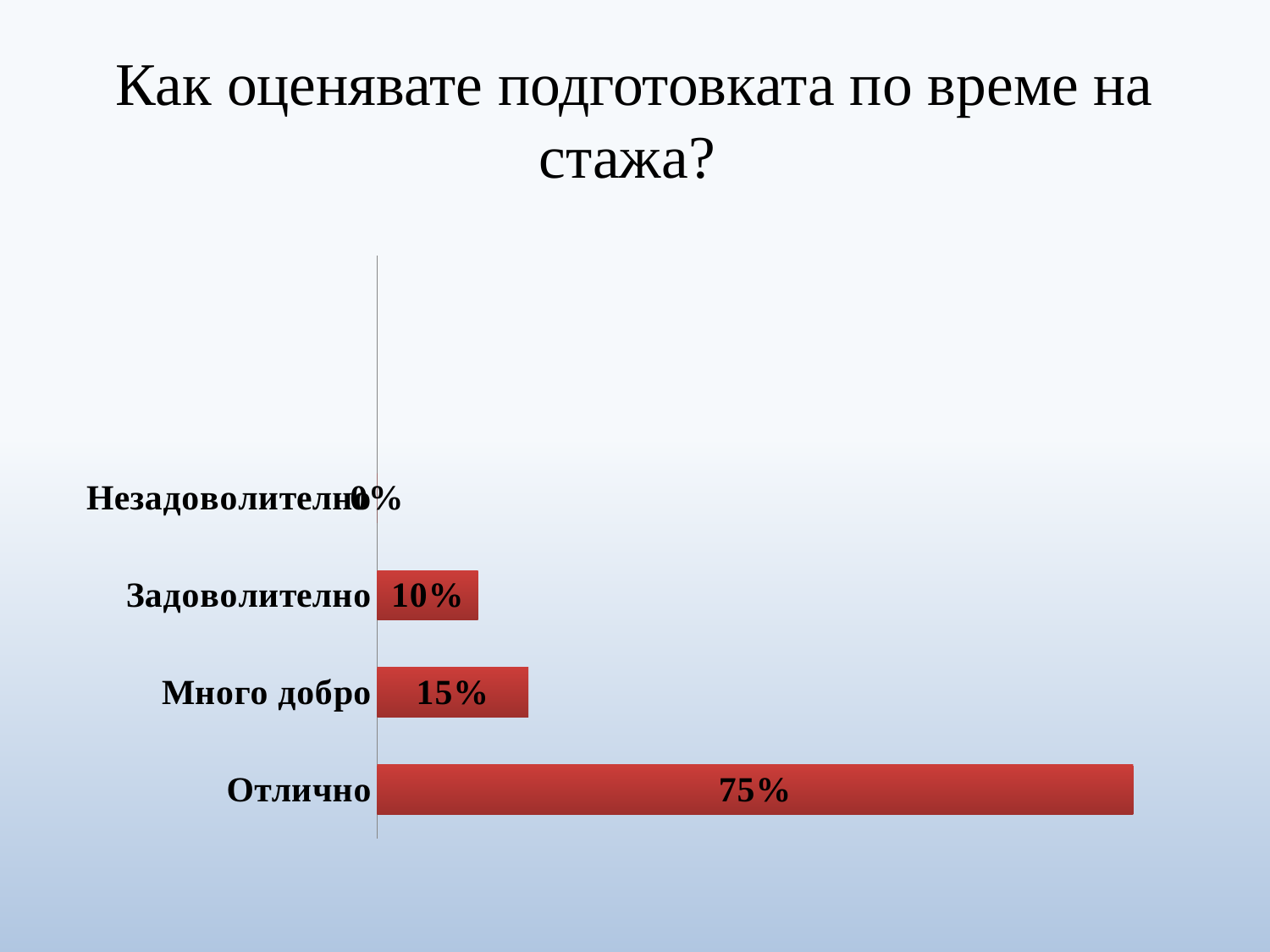
What kind of chart is shown on the slide? Bar chart Which is larger, the value for Задоволително or the value for Много добро? Много добро Which category has the lowest value? Незадоволително Which category has the highest value? Отлично How many categories are shown in the chart? 4 What value is shown for Задоволително? 10% What is the difference between the values for Отлично and Много добро? 60% What value is shown for Незадоволително? 0% What value is shown for Много добро? 15% What is the title of the slide? Как оценявате подготовката по време на стажа? What is the difference between the values for Много добро and Задоволително? 5% What value is shown for Отлично? 75%